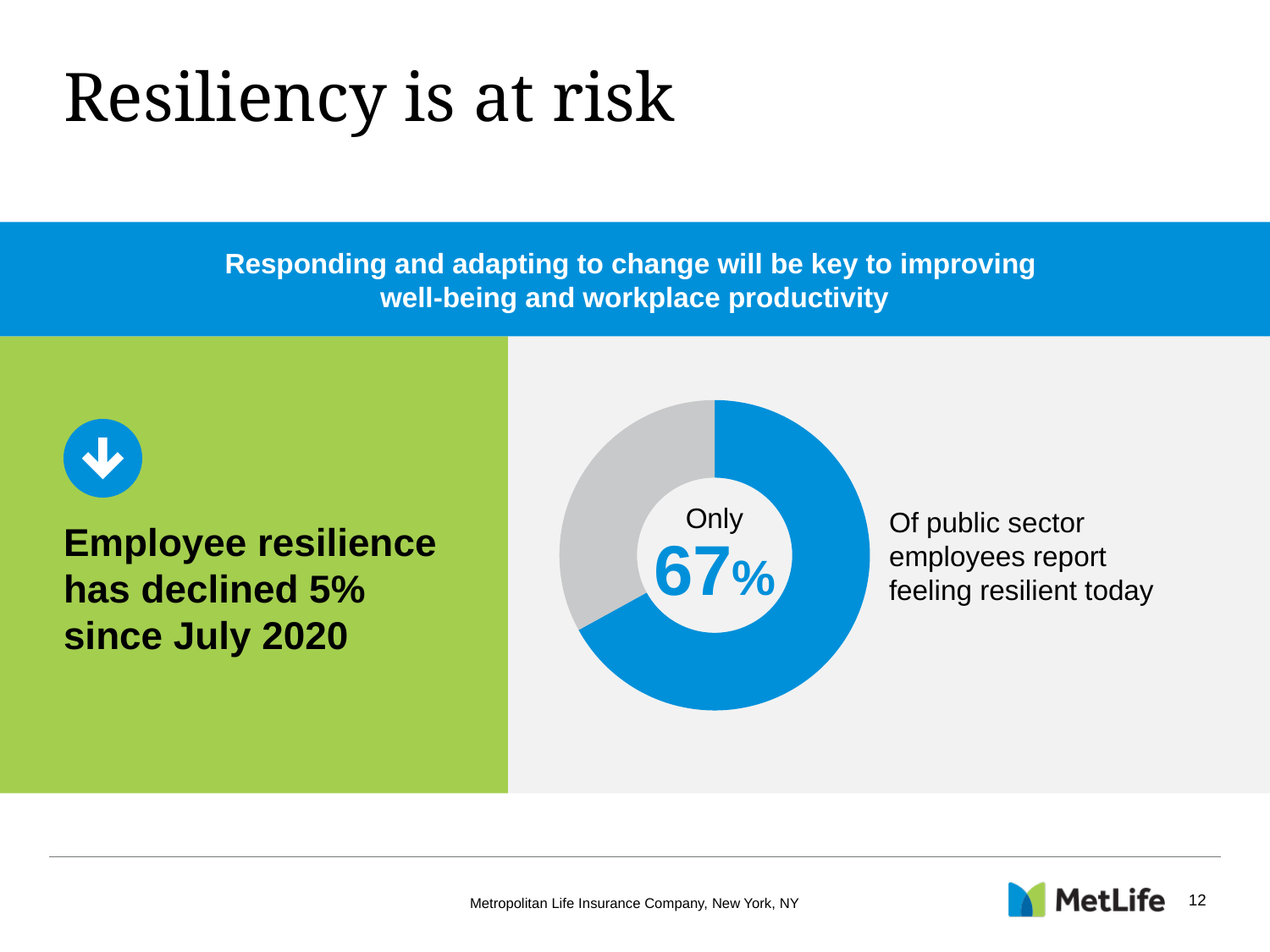
Which segment of the donut chart is larger, the blue one or the grey one? The blue one What kind of chart is shown on the slide? Donut chart What percentage of public sector employees report feeling resilient today, according to the chart? 67% What colour is the segment representing the 67% of employees who feel resilient? Blue What share of the donut chart is taken up by the blue segment? 67% What word appears above the 67% figure in the centre of the donut chart? Only Which segment of the donut chart is the smallest? The grey segment How many segments does the donut chart have? 2